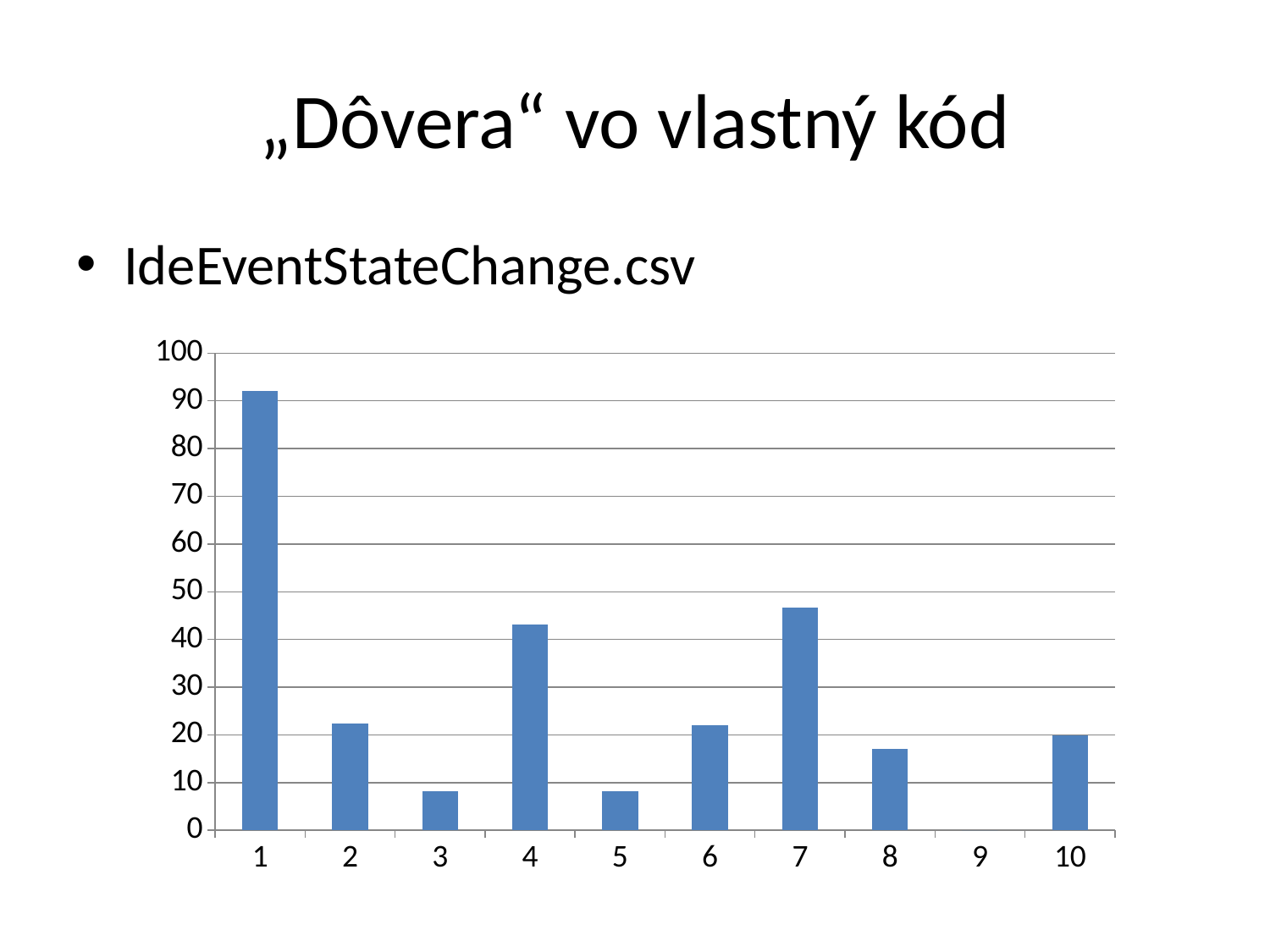
Is the value for category 3 greater or less than 10? less What is the value for category 9 in the chart? 0 Is the value for category 10 greater or less than 30? less Which category has the highest bar in the chart? 1 How many categories are shown on the x axis of the chart? 10 Is the value for category 1 greater or less than 80? greater Which has the larger value, category 1 or category 7? 1 What kind of chart is shown on the slide? bar chart Which has the larger value, category 4 or category 2? 4 Which category has the lowest value in the chart? 9